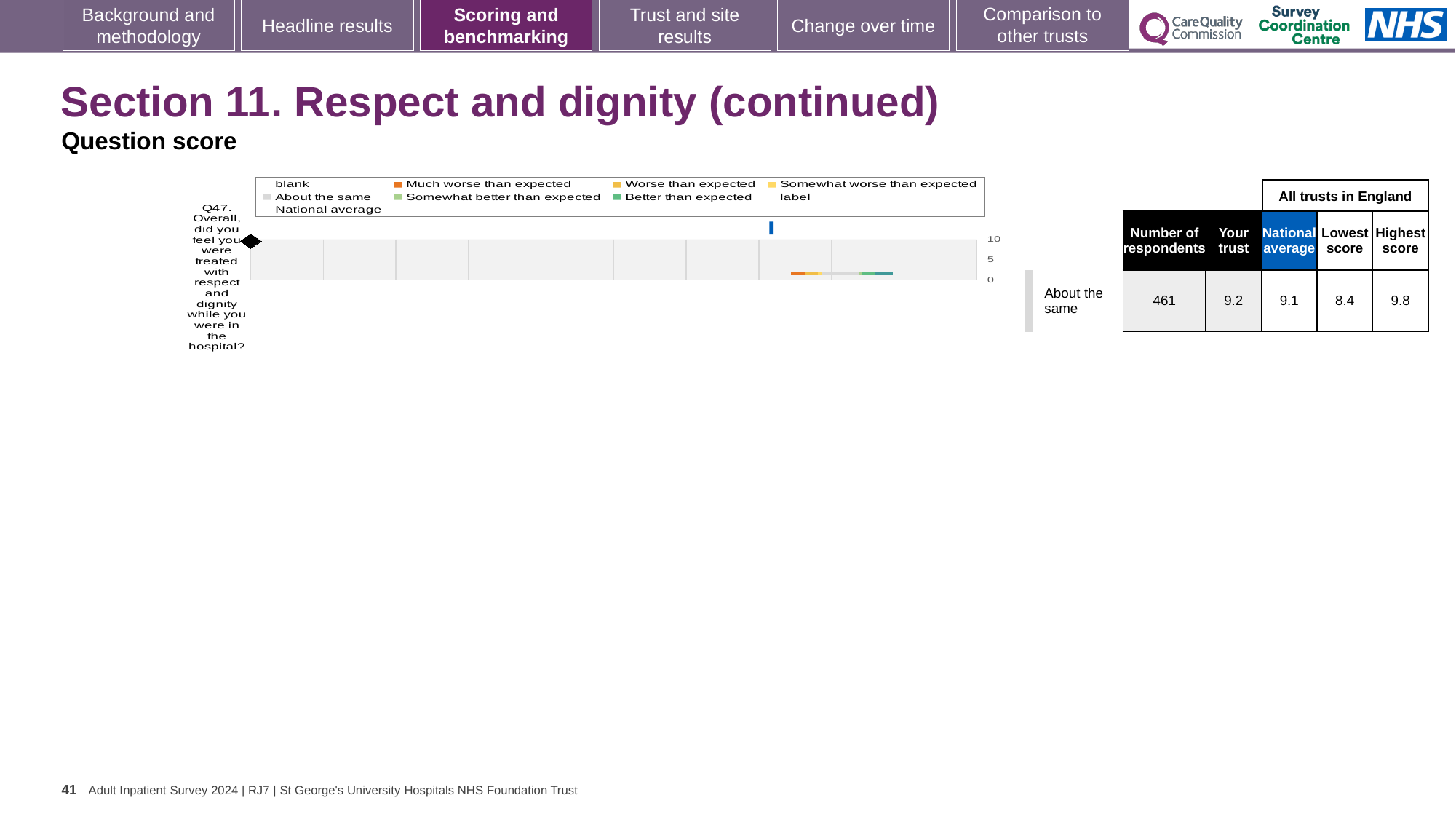
What is the national average score for Q47? 9.1 What kind of chart is shown on the slide for Q47? bar chart Which is larger for Q47, the 'Your trust' score or the national average? Your trust Is the 'Your trust' score for Q47 greater or less than 5? greater How many respondents answered Q47? 461 What is the highest score among all trusts in England for Q47? 9.8 What is the difference between the highest score and the lowest score for Q47? 1.4 What is the highest value shown on the chart's score axis? 10 Which question is plotted on the chart? Q47. Overall, did you feel you were treated with respect and dignity while you were in the hospital? What is the lowest score among all trusts in England for Q47? 8.4 What is the 'Your trust' score for Q47? 9.2 How many survey questions are plotted on the chart? 1